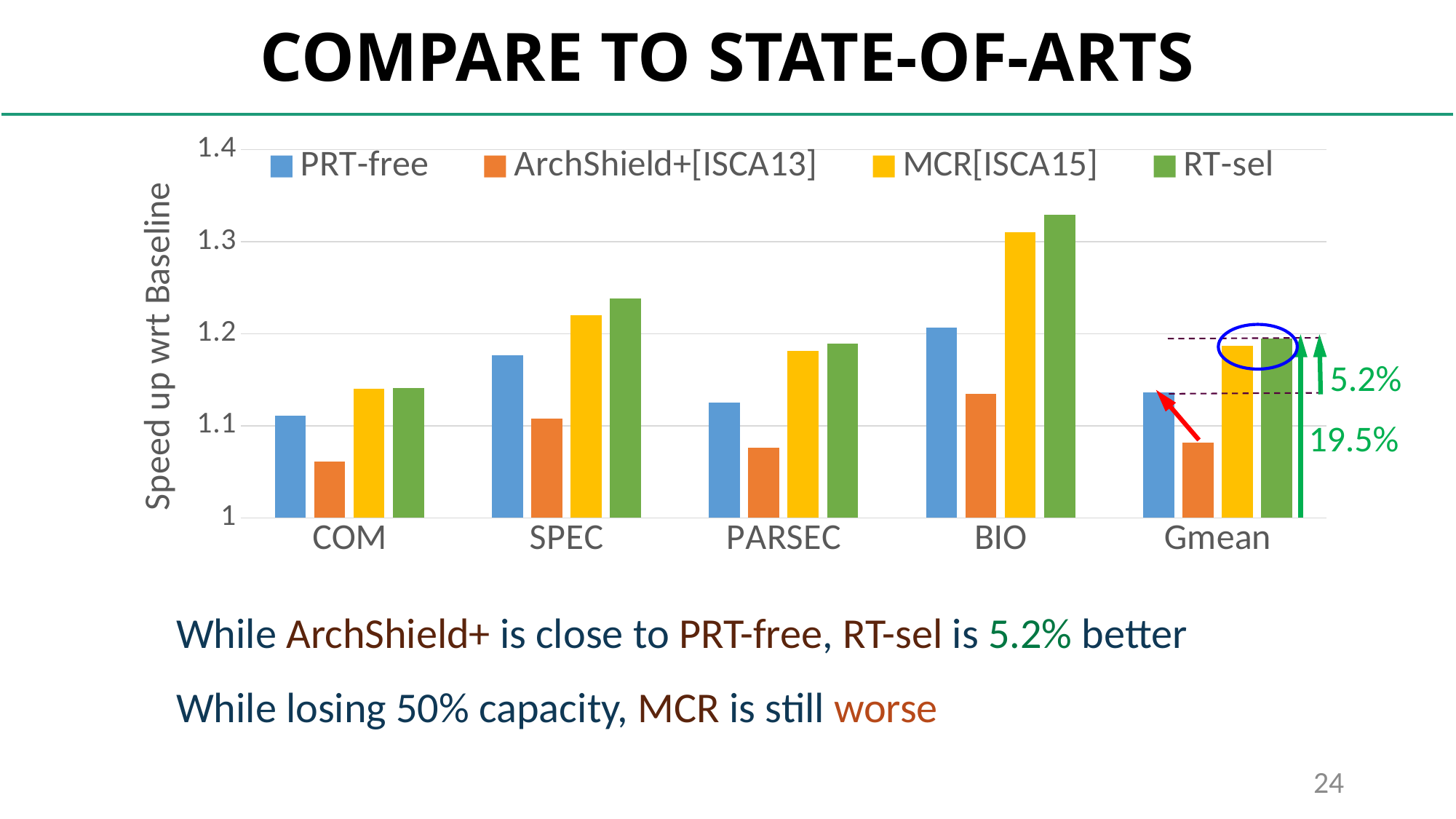
Which series has the lowest bar in the COM category? ArchShield+[ISCA13] Is the RT-sel value for BIO greater or less than 1.3? greater Which category has the highest RT-sel bar? BIO Is the MCR[ISCA15] value for SPEC greater or less than 1.2? greater Which category has the lowest ArchShield+[ISCA13] bar? COM Is the ArchShield+[ISCA13] value for COM greater or less than 1.1? less For BIO, which is larger: MCR[ISCA15] or PRT-free? MCR[ISCA15] What kind of chart is shown on the slide? bar chart What is the title of the y axis? Speed up wrt Baseline How many categories are shown on the x axis? 5 For SPEC, which is larger: PRT-free or ArchShield+[ISCA13]? PRT-free How many series does the legend list? 4